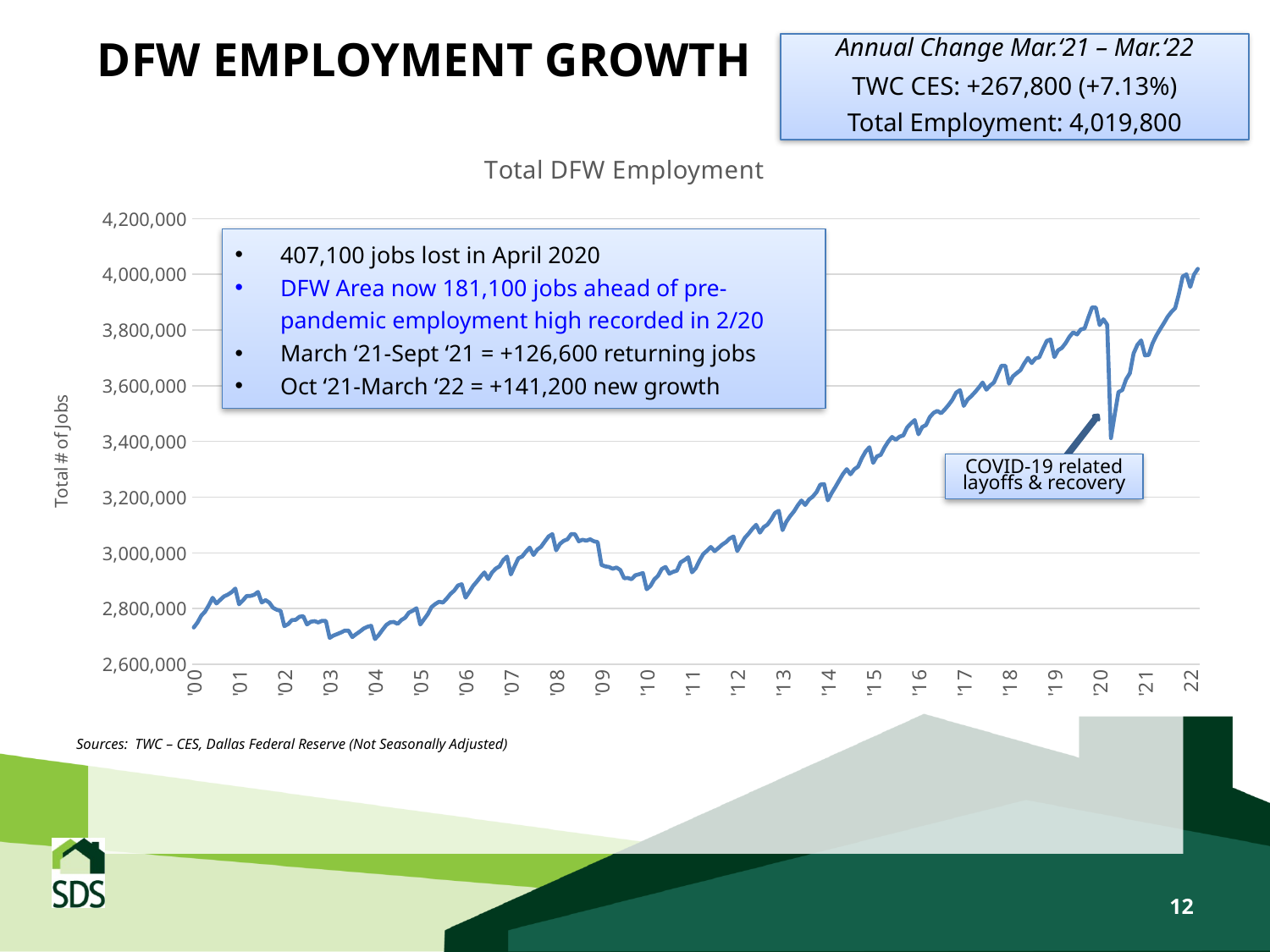
Overall, does total DFW employment rise or fall from '00 to '22? rise How many year labels are shown along the x-axis of the chart? 23 Which is higher, the value for '08 or the value for '10? '08 Is the value for '03 greater or less than 2,800,000? less Which year on the x-axis has the highest total DFW employment? '22 Is the value for '08 greater or less than 3,000,000? greater Is the value for '22 greater or less than 3,800,000? greater What kind of chart is shown on the slide? line chart What is the label on the y-axis of the chart? Total # of Jobs What is the title of the chart? Total DFW Employment